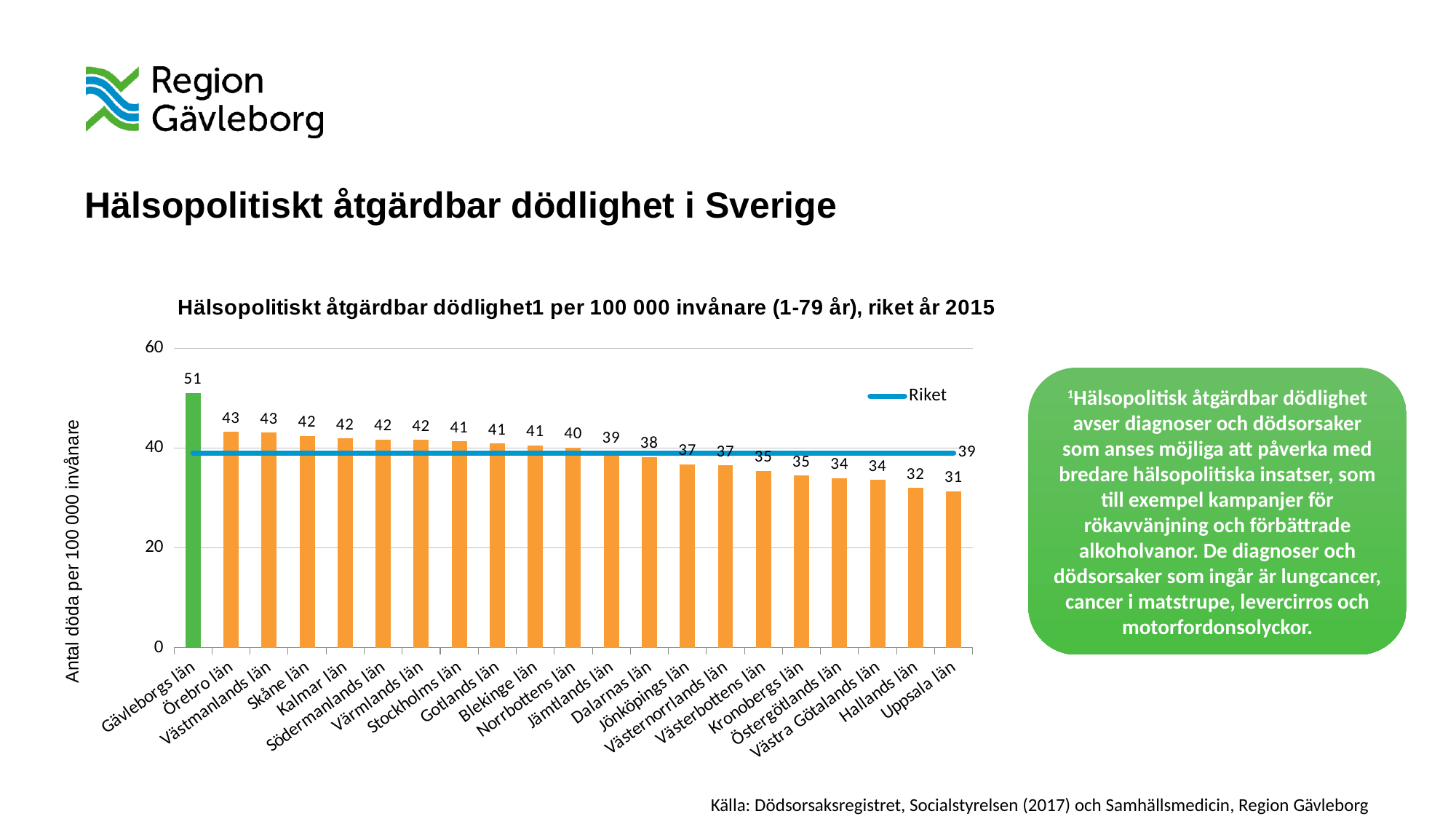
What is the value for Gävleborgs län? 51 Which county has the highest value? Gävleborgs län What is the difference between the values for Gävleborgs län and Uppsala län? 20 Which county has the lowest value? Uppsala län What is the value of the Riket line? 39 What is the difference between the value for Gävleborgs län and the Riket line? 12 How many counties are shown on the x axis? 21 What is the value for Uppsala län? 31 What kind of chart is this? Bar chart Which has a larger value, Örebro län or Hallands län? Örebro län What is the label of the y axis? Antal döda per 100 000 invånare Do the bar values rise or fall from left to right along the x axis? Fall